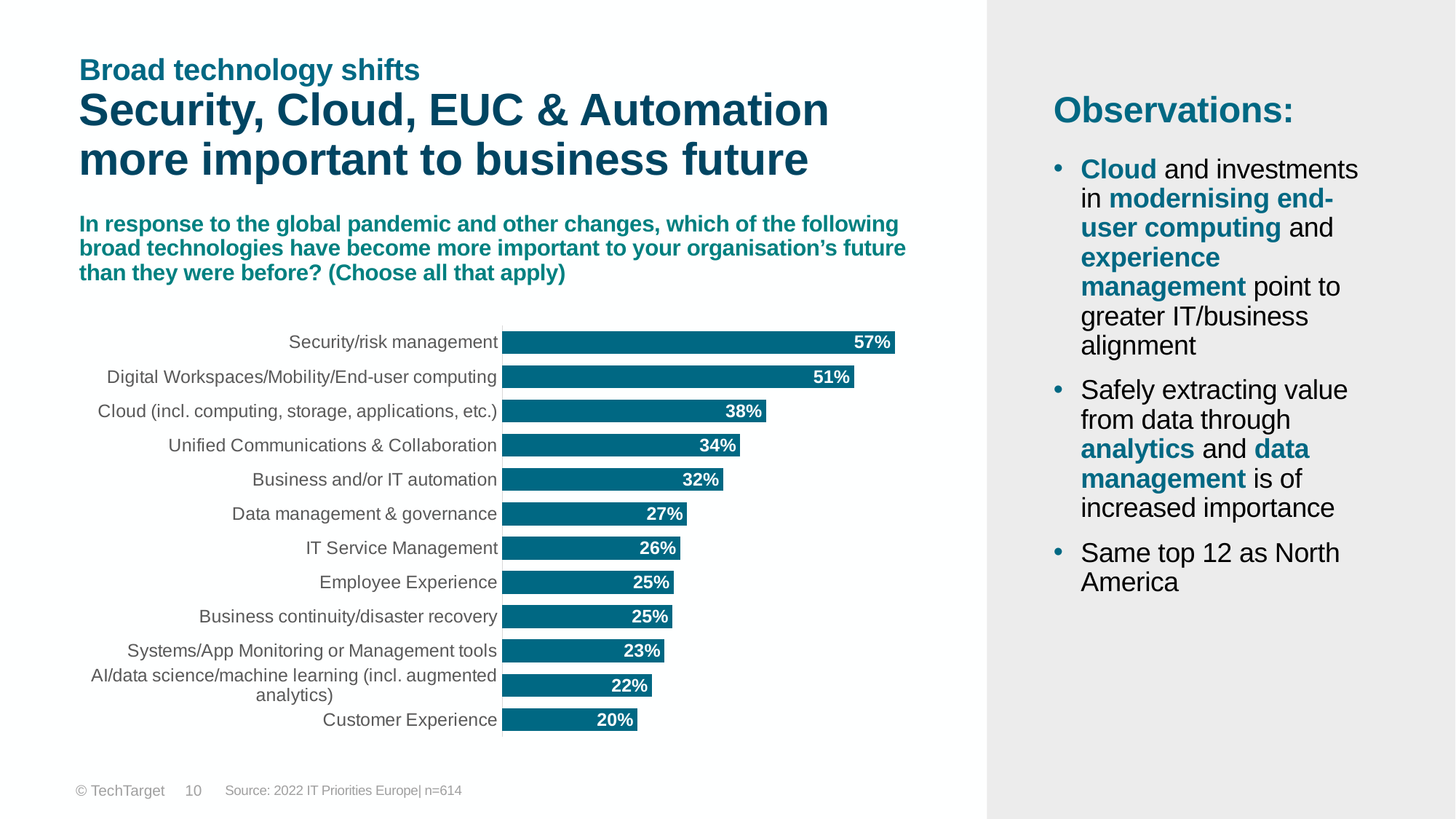
What type of chart is shown on the slide? Bar chart What percentage of respondents selected Security/risk management? 57% Which category has the lowest value in the chart? Customer Experience Which category has the highest value in the chart? Security/risk management What is the difference between the values for Security/risk management and Digital Workspaces/Mobility/End-user computing? 6% What is the value shown for AI/data science/machine learning (incl. augmented analytics)? 22% Which has a larger value: Unified Communications & Collaboration or Data management & governance? Unified Communications & Collaboration Which has a larger value: IT Service Management or Systems/App Monitoring or Management tools? IT Service Management How many categories are shown in the chart? 12 What percentage is shown for Business and/or IT automation? 32% What is the value shown for Cloud (incl. computing, storage, applications, etc.)? 38% What is the difference between the values for Cloud (incl. computing, storage, applications, etc.) and Customer Experience? 18%